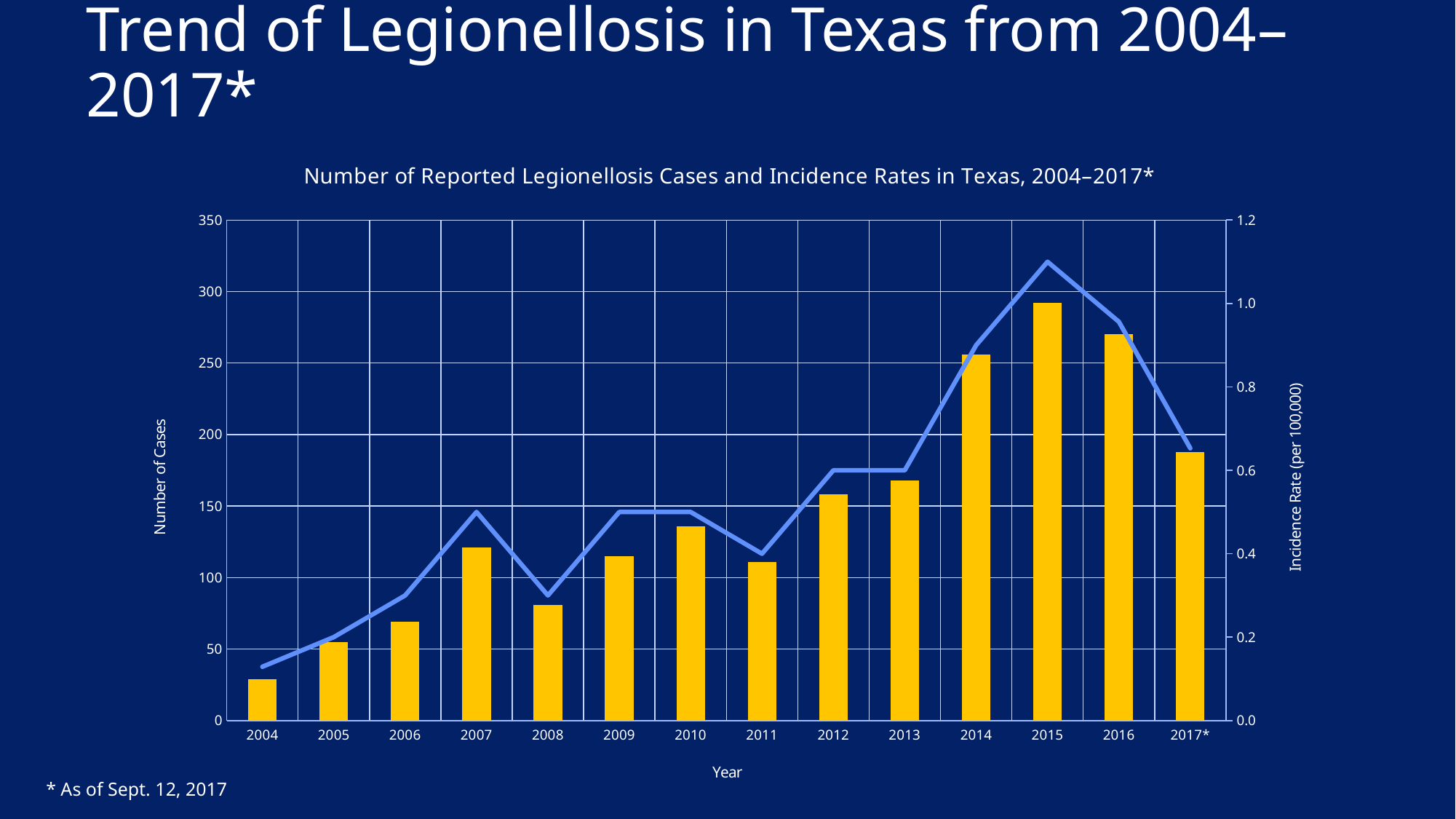
Which year had more reported cases, 2007 or 2008? 2007 Is the number of cases in 2004 greater or less than 50? less Which year has the lowest number of reported legionellosis cases? 2004 What kind of chart is used to show the number of cases? Bar chart (with a line for incidence rate) Is the number of cases in 2015 greater or less than 250? greater Which year had more reported cases, 2014 or 2016? 2016 Is the number of cases in 2017* greater or less than 200? less What is the label of the right-hand vertical axis? Incidence Rate (per 100,000) Which year has the highest number of reported legionellosis cases? 2015 How many years are shown on the x axis? 14 Did the number of reported cases rise or fall from 2015 to 2017*? Fall